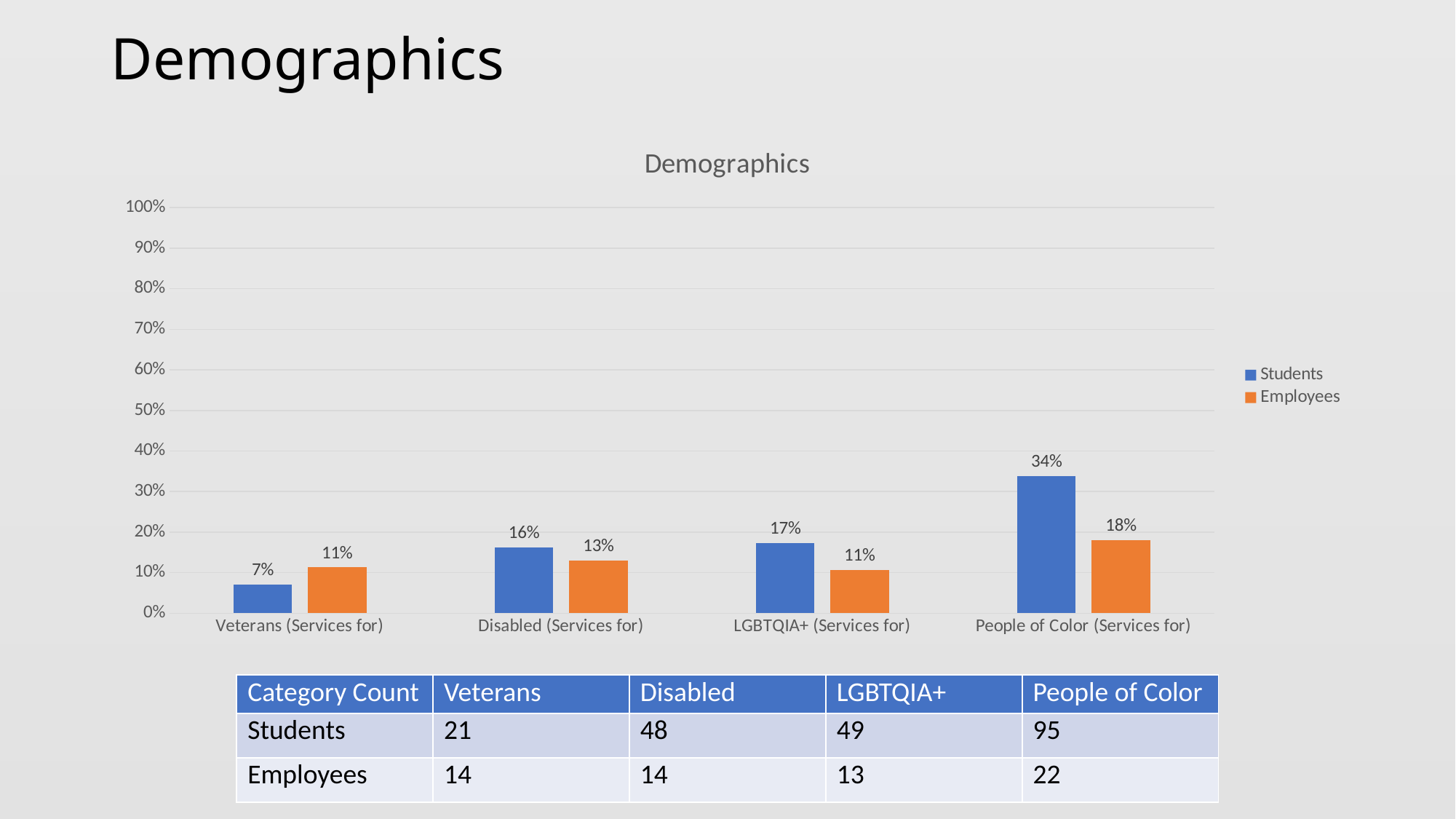
How many series does the legend list? 2 What is the title of the chart? Demographics Is the Students value for People of Color (Services for) greater or less than 30%? greater What kind of chart is shown? bar chart How many categories are shown on the x axis? 4 What is the Employees value for People of Color (Services for)? 18% What is the difference between the Students and Employees values for People of Color (Services for)? 16% For Veterans (Services for), which is larger: the Students value or the Employees value? Employees Which category has the highest Students value? People of Color (Services for) What is the Students value for Veterans (Services for)? 7% What is the Students value for LGBTQIA+ (Services for)? 17% Which category has the lowest Students value? Veterans (Services for)